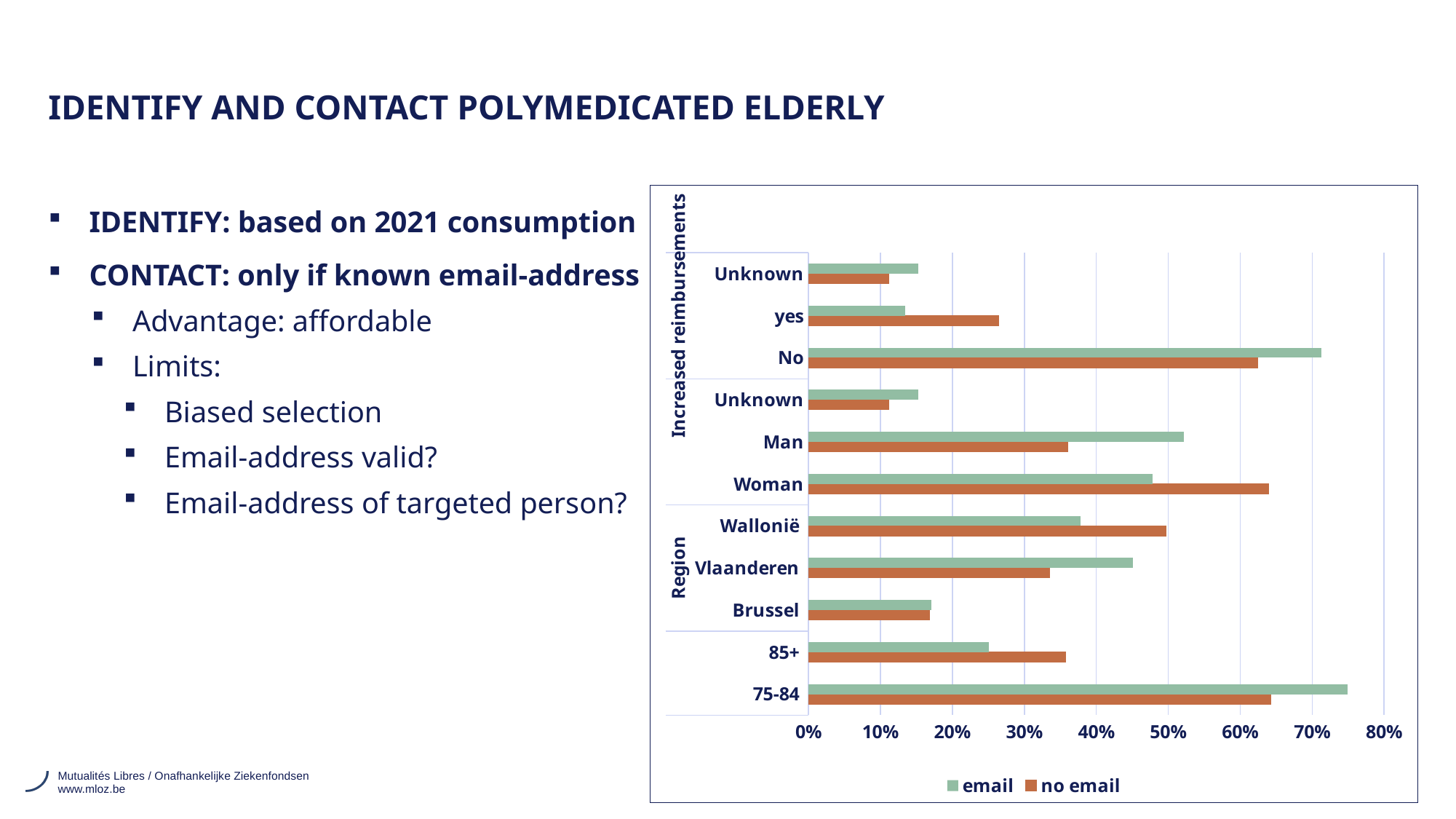
Which category has the highest value for the email series? 75-84 How many categories are plotted on the chart's vertical axis? 11 What kind of chart is shown on the slide? bar chart What are the two series named in the chart's legend? email and no email Is the no email value for Vlaanderen greater or less than 40%? less For Woman, which series has the larger value, email or no email? no email How many series does the chart's legend list? 2 Is the email value for 75-84 greater or less than 70%? greater Is the no email value for Woman greater or less than 60%? greater For 85+, which series has the larger value, email or no email? no email For Man, which series has the larger value, email or no email? email